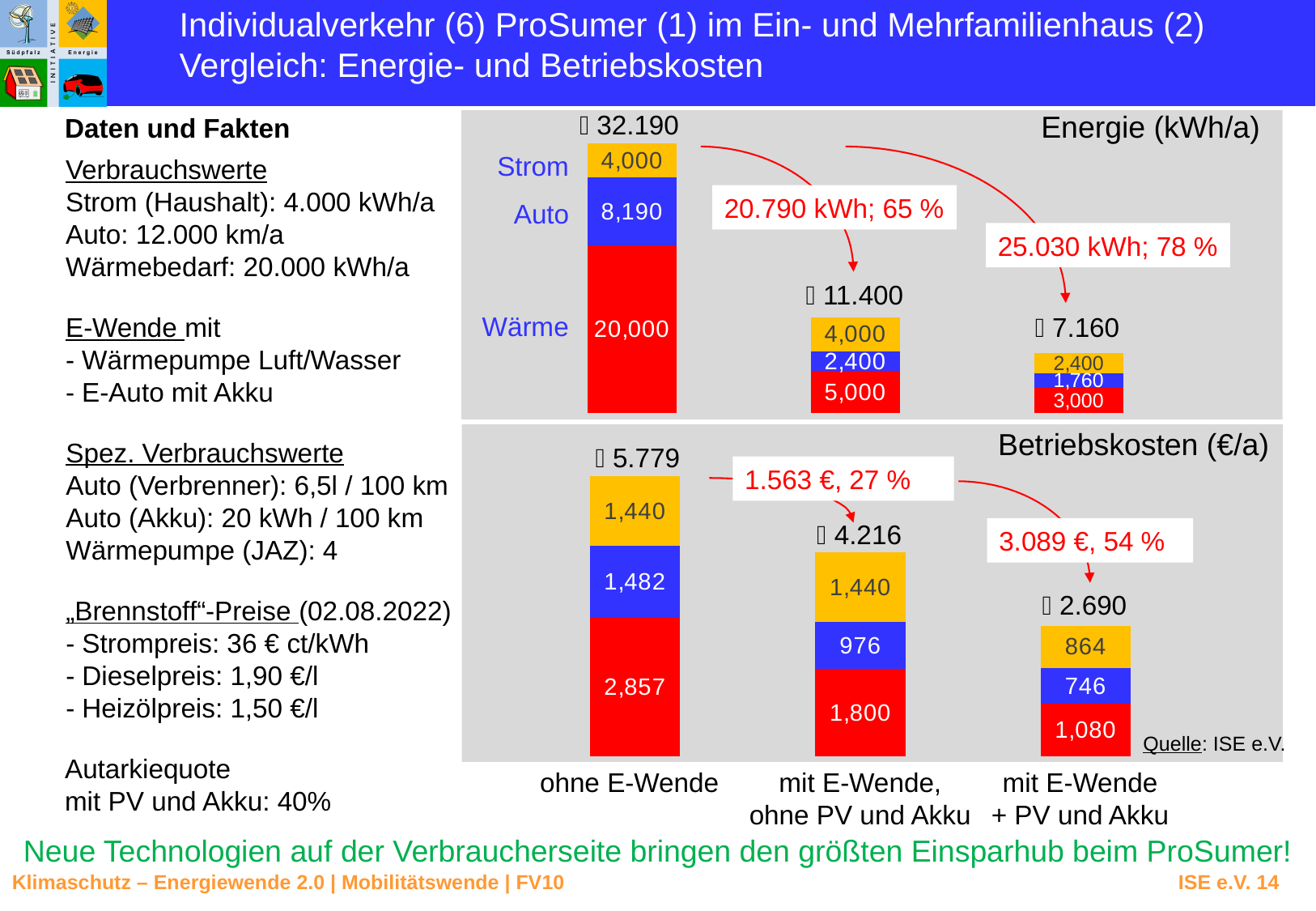
In the Betriebskosten (€/a) chart, what is the Auto value for 'mit E-Wende + PV und Akku'? 746 In the Energie (kWh/a) chart, what is the Auto value for 'mit E-Wende, ohne PV und Akku'? 2,400 In the Energie (kWh/a) chart, what is the Wärme value for 'ohne E-Wende'? 20,000 In the Betriebskosten (€/a) chart, what is the Wärme value for 'ohne E-Wende'? 2,857 What type of chart is used for the Energie (kWh/a) data? Stacked bar chart In the Energie (kWh/a) chart, what is the total shown above the 'mit E-Wende + PV und Akku' bar? 7.160 In the Energie (kWh/a) chart, what is the difference between the Wärme values for 'ohne E-Wende' and 'mit E-Wende, ohne PV und Akku'? 15,000 In the Energie (kWh/a) chart, which scenario has the highest total? ohne E-Wende In the Betriebskosten (€/a) chart, which is larger for 'ohne E-Wende': the Strom value or the Auto value? Auto How many scenarios (bars) does each chart show? 3 In the Betriebskosten (€/a) chart, which scenario has the lowest total? mit E-Wende + PV und Akku In the Betriebskosten (€/a) chart, what is the total shown above the 'mit E-Wende, ohne PV und Akku' bar? 4.216